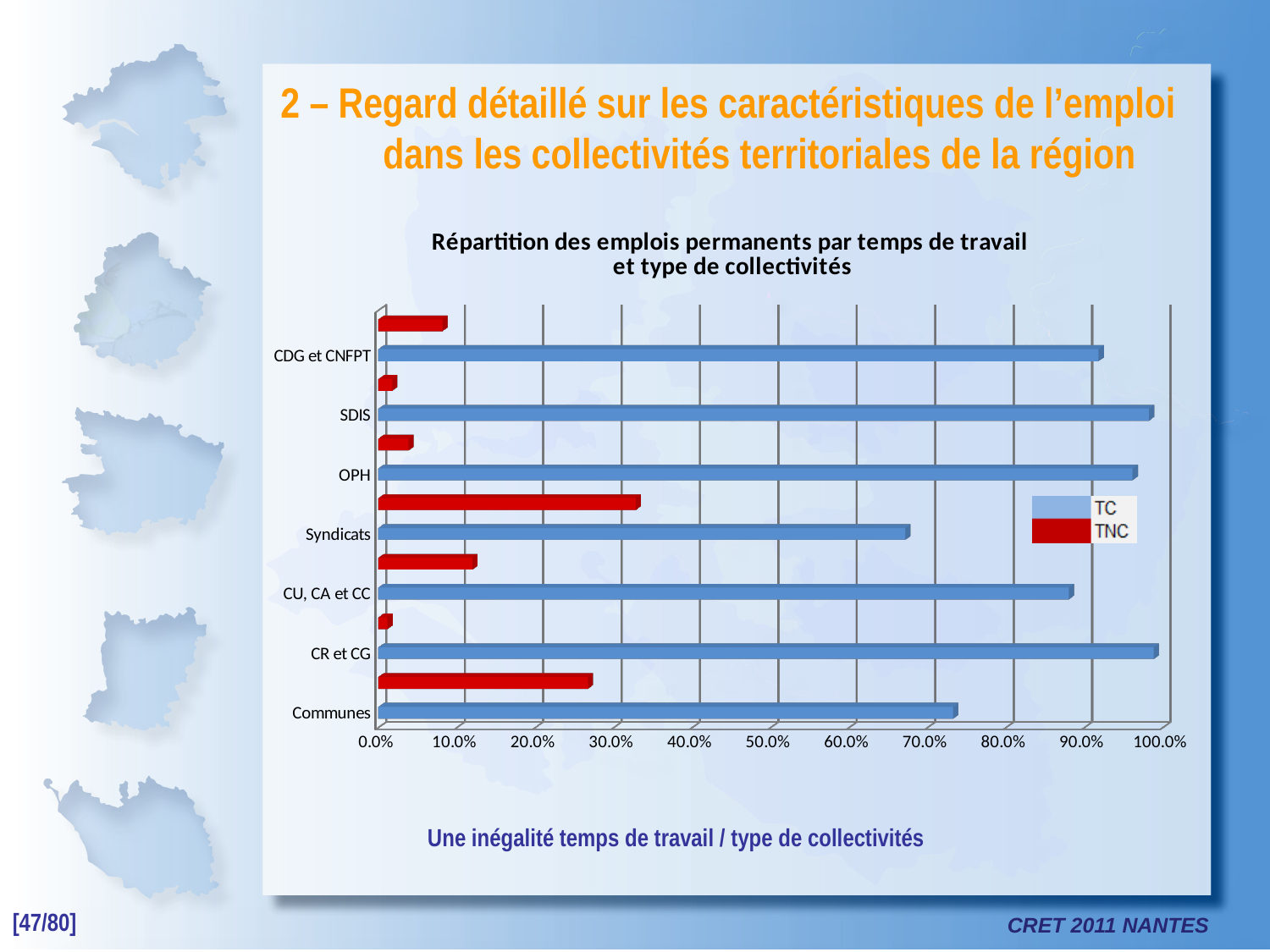
Is the TC value for Communes greater or less than 70.0%? greater How many series does the legend list? 2 Is the TC value for CDG et CNFPT greater or less than 90.0%? greater Is the TNC value for CU, CA et CC greater or less than 20.0%? less Which category has the highest TNC value? Syndicats Which colour represents the TNC series in the legend? red What kind of chart is shown on the slide? bar chart How many types of collectivités (categories) are shown on the chart? 7 Which is larger, the TNC value for Communes or the TNC value for CU, CA et CC? Communes Which is larger, the TC value for OPH or the TC value for Syndicats? OPH Which category has the lowest TC value? Syndicats